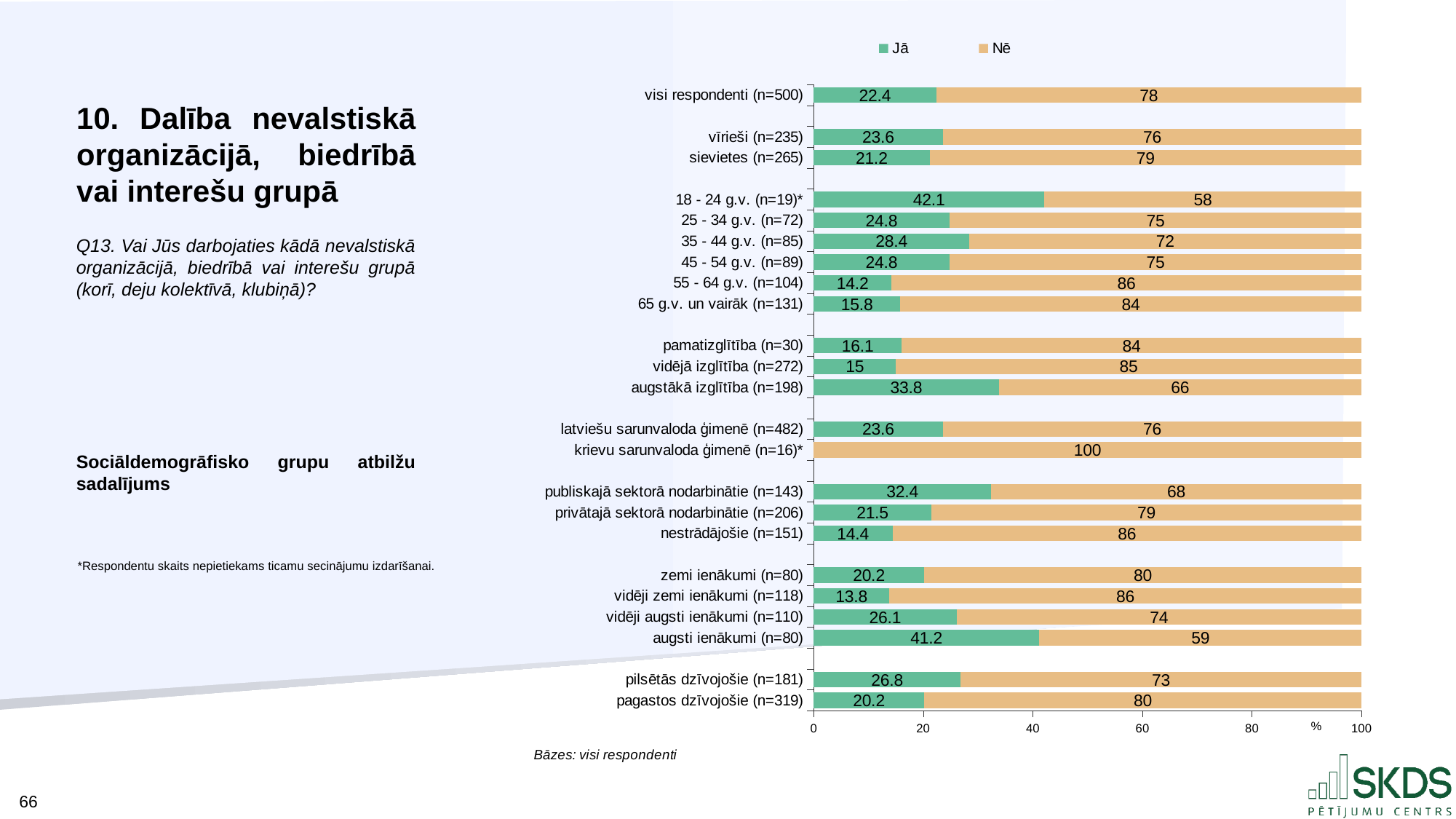
Which category has the highest "Jā" value? 18 - 24 g.v. (n=19)* What is the "Nē" value for augstākā izglītība (n=198)? 66 Which category has the highest "Nē" value? krievu sarunvaloda ģimenē (n=16)* Which category has the lowest "Nē" value? 18 - 24 g.v. (n=19)* How many series does the legend list? 2 Which has the larger "Jā" value: publiskajā sektorā nodarbinātie (n=143) or privātajā sektorā nodarbinātie (n=206)? publiskajā sektorā nodarbinātie (n=143) What is the difference between the "Jā" values for 18 - 24 g.v. (n=19)* and 55 - 64 g.v. (n=104)? 27.9 What is the "Jā" value for visi respondenti (n=500)? 22.4 Is the "Nē" value for augsti ienākumi (n=80) greater or less than 60? less What kind of chart is shown on the slide? stacked bar chart How many categories are shown on the chart? 23 What is the "Jā" value for augsti ienākumi (n=80)? 41.2